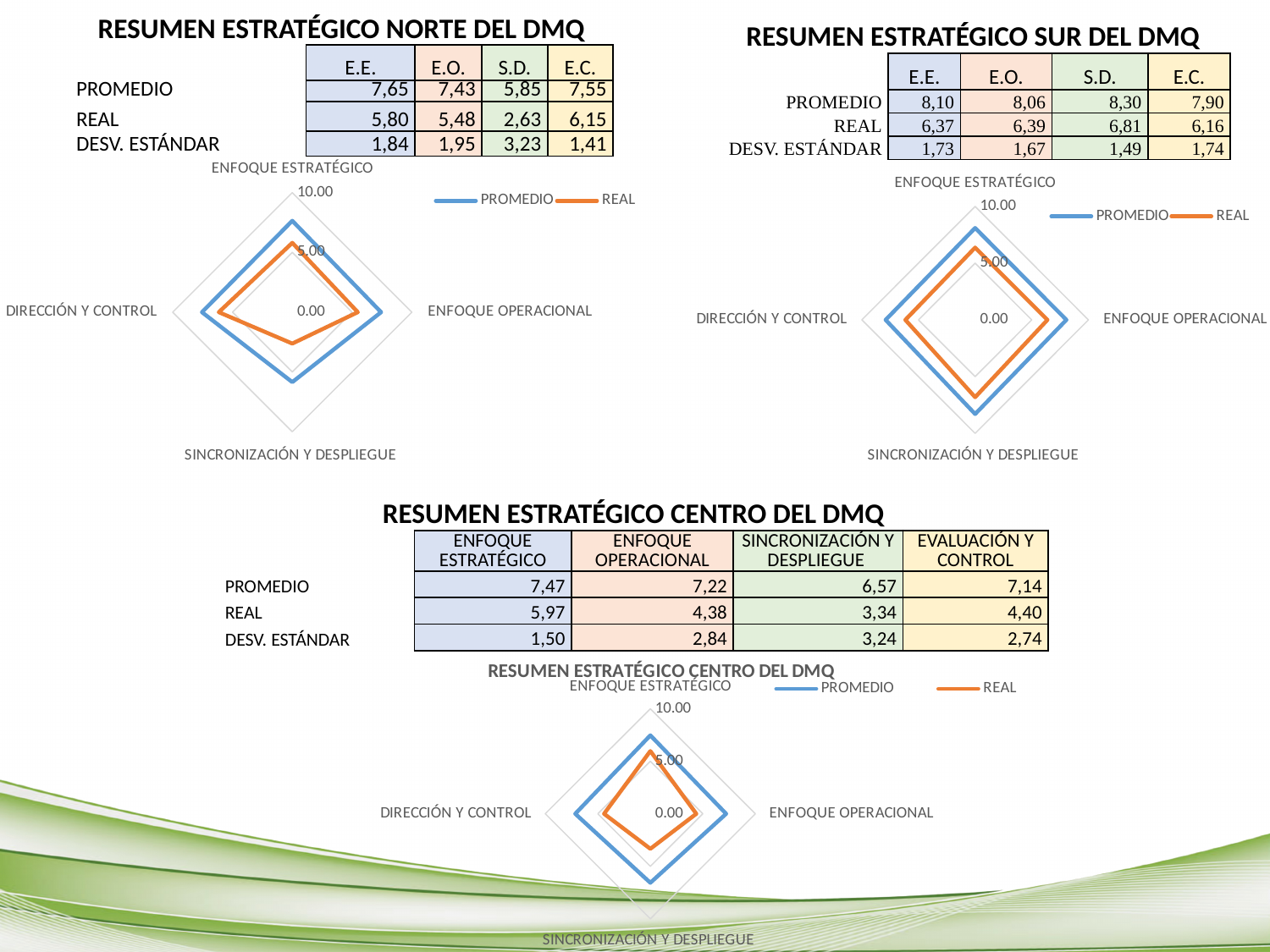
In the Resumen Estratégico Sur del DMQ chart, is the REAL value for Dirección y Control greater or less than 5.00? greater In the Resumen Estratégico Centro del DMQ chart, is the PROMEDIO value for Enfoque Estratégico greater or less than 5.00? greater In the Resumen Estratégico Centro del DMQ chart, is the REAL value for Sincronización y Despliegue greater or less than 5.00? less In the Resumen Estratégico Norte del DMQ chart, which series has the larger value for Dirección y Control, PROMEDIO or REAL? PROMEDIO In the Resumen Estratégico Sur del DMQ chart, which series has the larger value for Sincronización y Despliegue, PROMEDIO or REAL? PROMEDIO What are the two legend entries of the Resumen Estratégico Centro del DMQ chart? PROMEDIO and REAL How many axes (categories) does the Resumen Estratégico Centro del DMQ radar chart have? 4 What kind of chart is the Resumen Estratégico Norte del DMQ chart? Radar chart How many series does the legend of the Resumen Estratégico Sur del DMQ chart list? 2 In the Resumen Estratégico Norte del DMQ chart, what colour is the REAL series line? Orange